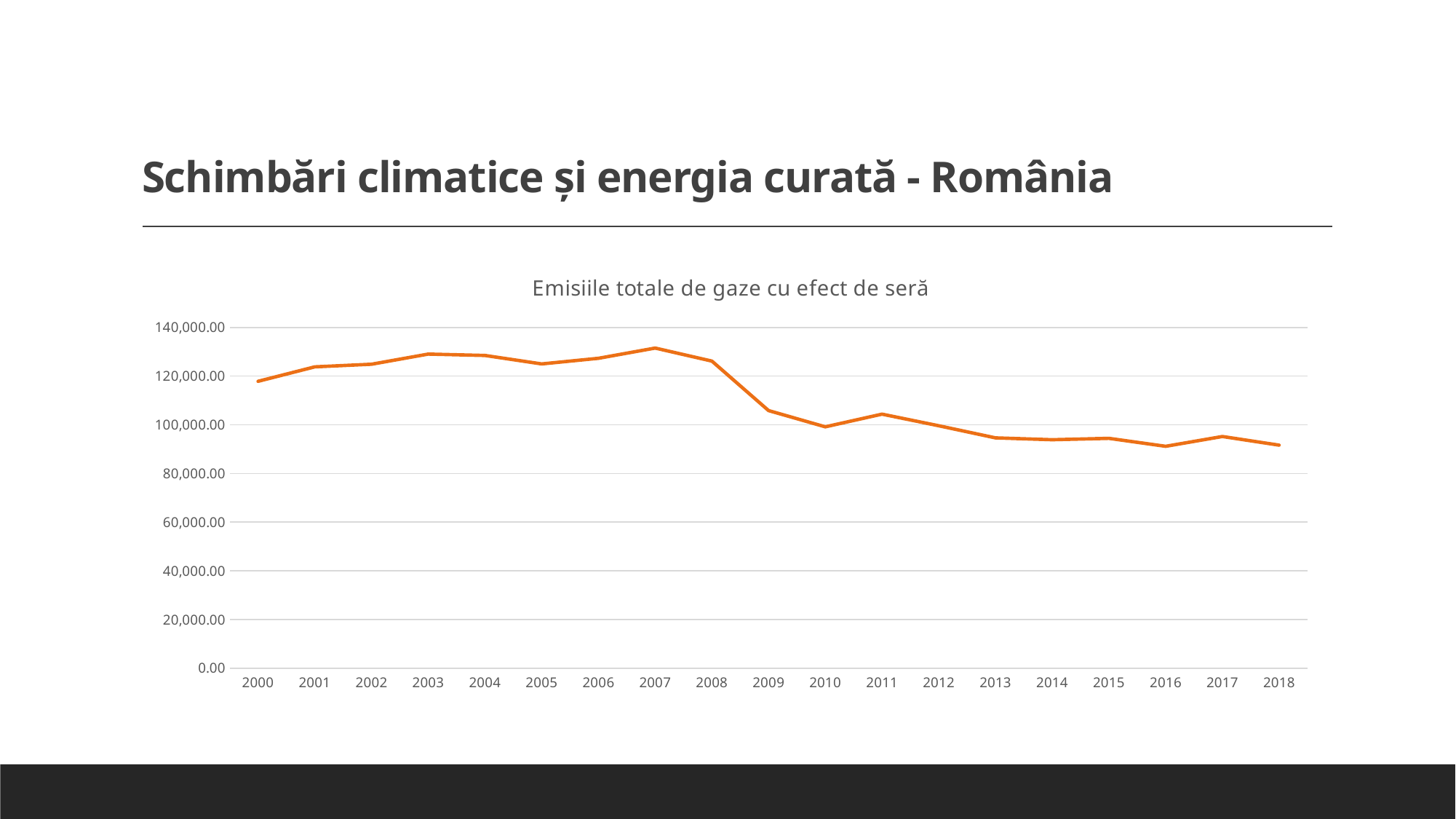
Is the value for 2003 greater or less than 120,000.00? greater How many years are plotted along the x axis? 19 Which year has the highest value on the chart? 2007 Overall, do the values rise or fall from 2000 to 2018? fall What is the title of the chart? Emisiile totale de gaze cu efect de seră Is the value for 2016 greater or less than 100,000.00? less Which is larger, the value for 2007 or the value for 2016? 2007 Is the value for 2007 greater or less than 120,000.00? greater Do the values rise or fall between 2008 and 2010? fall What kind of chart is shown on the slide? line chart Which is larger, the value for 2000 or the value for 2018? 2000